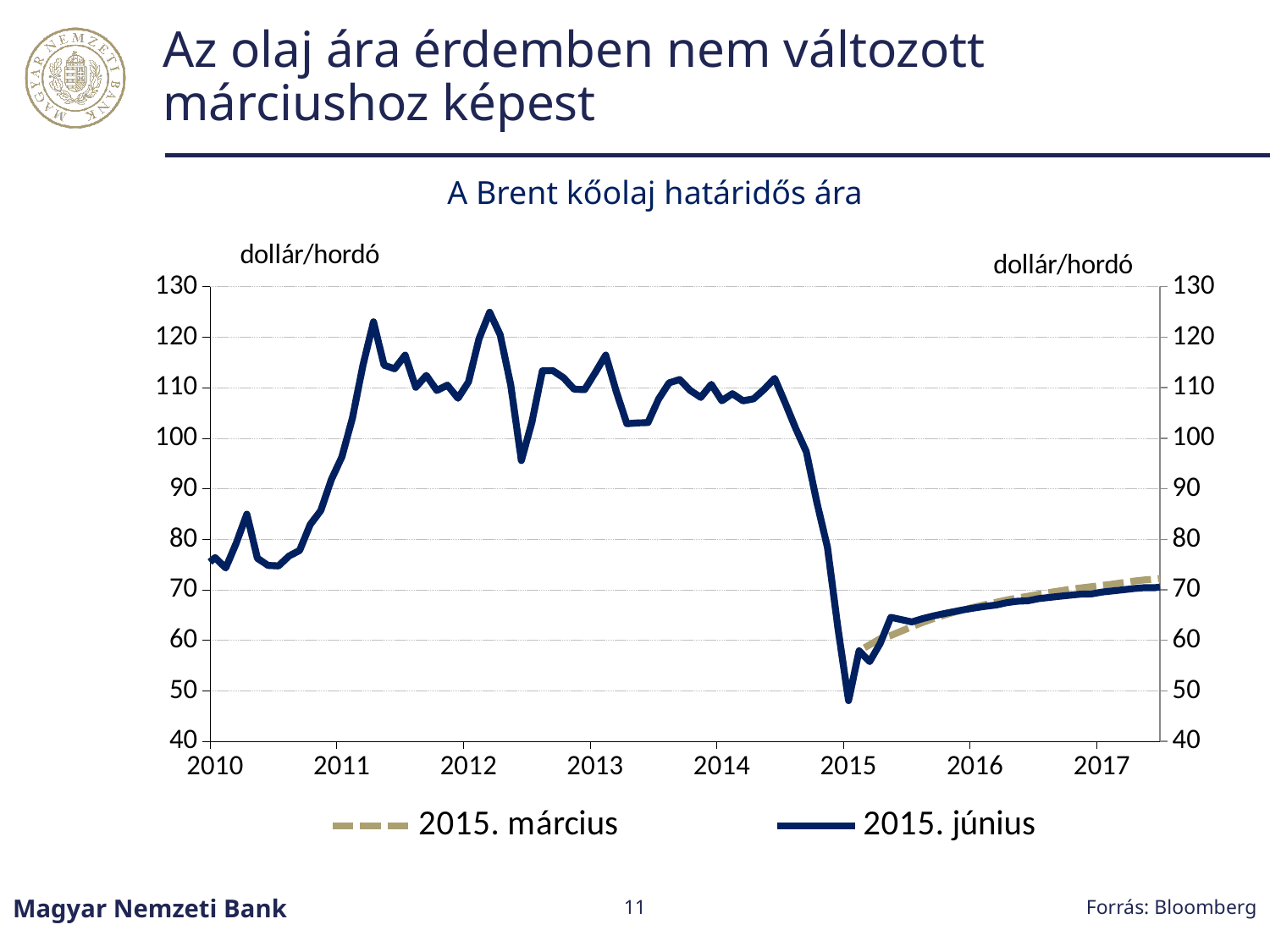
Is the value of the 2015. június series at the start of 2014 greater or less than 100? greater Is the value of the 2015. június series at the start of 2010 greater or less than 70? greater Which is larger for the 2015. június series: the value at the start of 2013 or the value at the start of 2015? the start of 2013 Does the 2015. június series rise or fall between the start of 2014 and the start of 2015? fall How many series does the legend list? 2 Does the 2015. június series rise or fall between mid-2015 and 2017? rise What is the title of the chart? A Brent kőolaj határidős ára What kind of chart is shown on the slide? line chart What are the two series named in the legend? 2015. március and 2015. június Is the lowest point of the 2015. június series, reached in early 2015, greater or less than 50? less How many year labels are shown on the x axis? 8